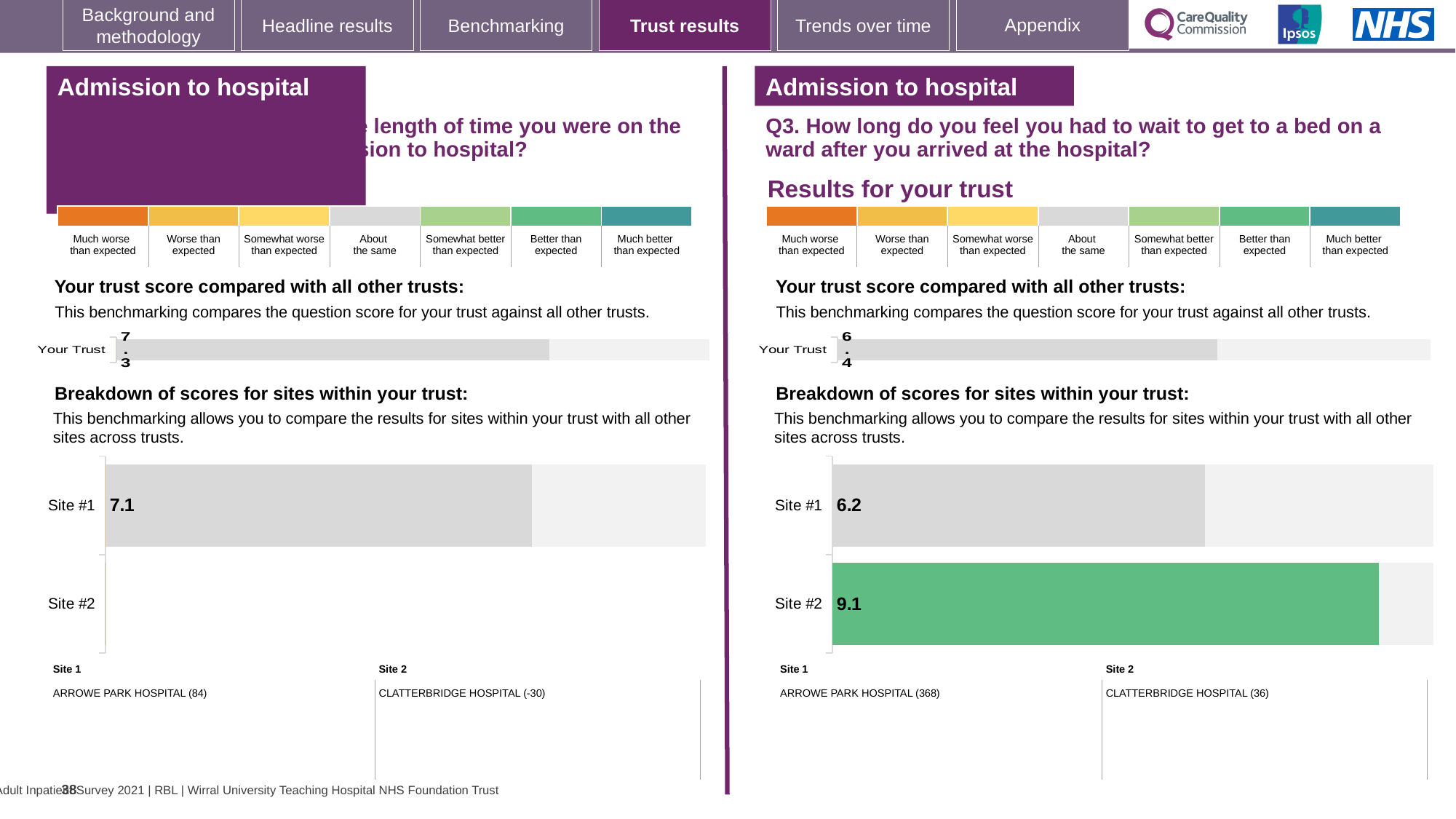
What type of chart is used for the site breakdown on the right-hand side of the slide? Bar chart How many sites are listed on the left-hand site breakdown chart? 2 On the right-hand Q3 site breakdown chart, what is the difference between the scores for Site #2 and Site #1? 2.9 On the right-hand chart for Q3 (breakdown of scores for sites within your trust), what is the score for Site #1? 6.2 On the right-hand chart for Q3 (breakdown of scores for sites within your trust), what is the score for Site #2? 9.1 On the right-hand Q3 site breakdown chart, is the score for Site #2 greater or less than the score for Site #1? Greater On the right-hand Q3 site breakdown chart, what colour is the bar for Site #2? Green Which is larger: the Site #1 score on the left-hand site breakdown chart or the Site #1 score on the right-hand Q3 site breakdown chart? The left-hand chart (7.1) On the left-hand site breakdown chart, what is the score for Site #1? 7.1 On the right-hand Q3 'Your trust score compared with all other trusts' chart, what is the score for Your Trust? 6.4 On the left-hand 'Your trust score compared with all other trusts' chart, what is the score for Your Trust? 7.3 On the right-hand Q3 site breakdown chart, which site has the higher score? Site #2